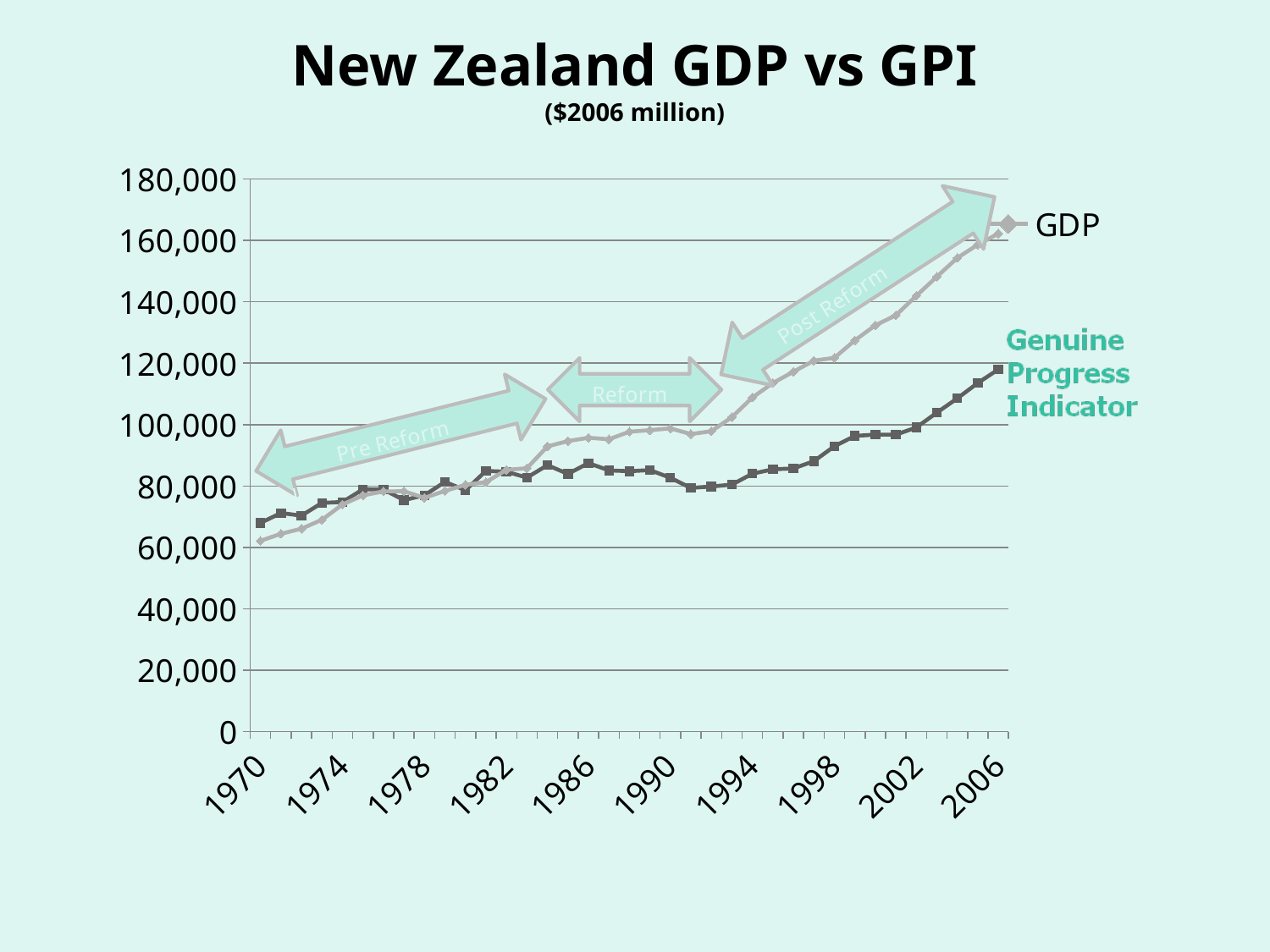
In which year does the GDP series reach its highest value? 2006 Is the GDP value for 1970 greater or less than 80,000? less What kind of chart is shown on the slide? line chart What is the title of the chart? New Zealand GDP vs GPI Does the GDP series generally rise or fall from 1970 to 2006? rise Is the Genuine Progress Indicator value for 1970 greater or less than 80,000? less Is the Genuine Progress Indicator value for 2006 greater or less than 100,000? greater In 1970, which series has the higher value, GDP or Genuine Progress Indicator? Genuine Progress Indicator How many series are plotted on the chart? 2 In 2006, which series has the higher value, GDP or Genuine Progress Indicator? GDP What unit is stated under the chart title? $2006 million